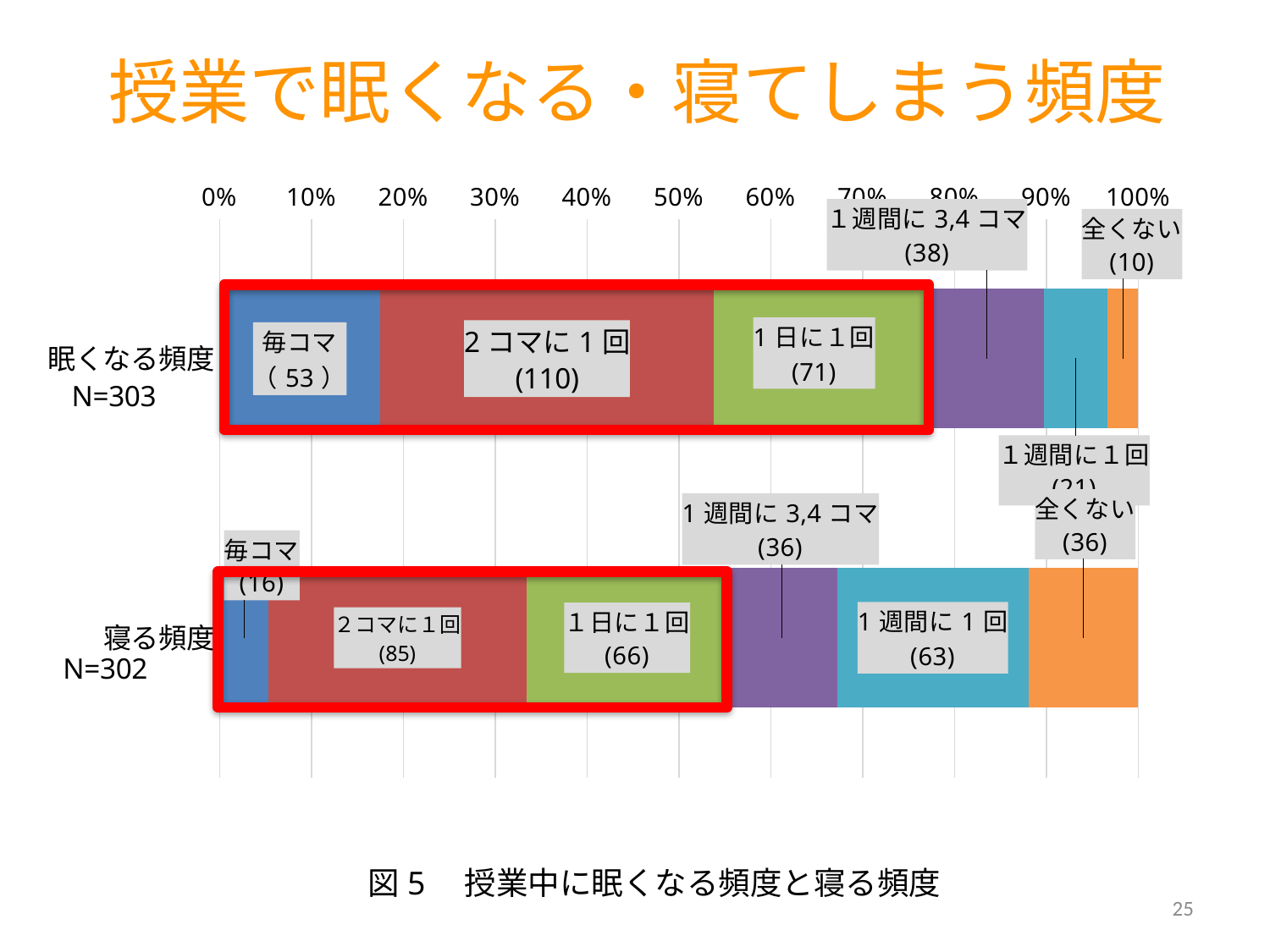
What is the value labelled for 毎コマ in the 眠くなる頻度 bar? 53 Which segment has the smallest value in the 寝る頻度 bar? 毎コマ What is the value labelled for 1週間に1回 in the 寝る頻度 bar? 63 What kind of chart is shown on the slide? Stacked bar chart What is the value labelled for 2コマに1回 in the 眠くなる頻度 bar? 110 What is the difference between the 2コマに1回 values for 眠くなる頻度 and 寝る頻度? 25 How many bars (categories) does the chart show? 2 Which is larger: 全くない for 眠くなる頻度 or 全くない for 寝る頻度? 寝る頻度 Which segment has the largest value in the 眠くなる頻度 bar? 2コマに1回 What is the value labelled for 全くない in the 眠くなる頻度 bar? 10 What is the N (sample size) shown for the 寝る頻度 bar? N=302 What is the value labelled for 1日に1回 in the 寝る頻度 bar? 66